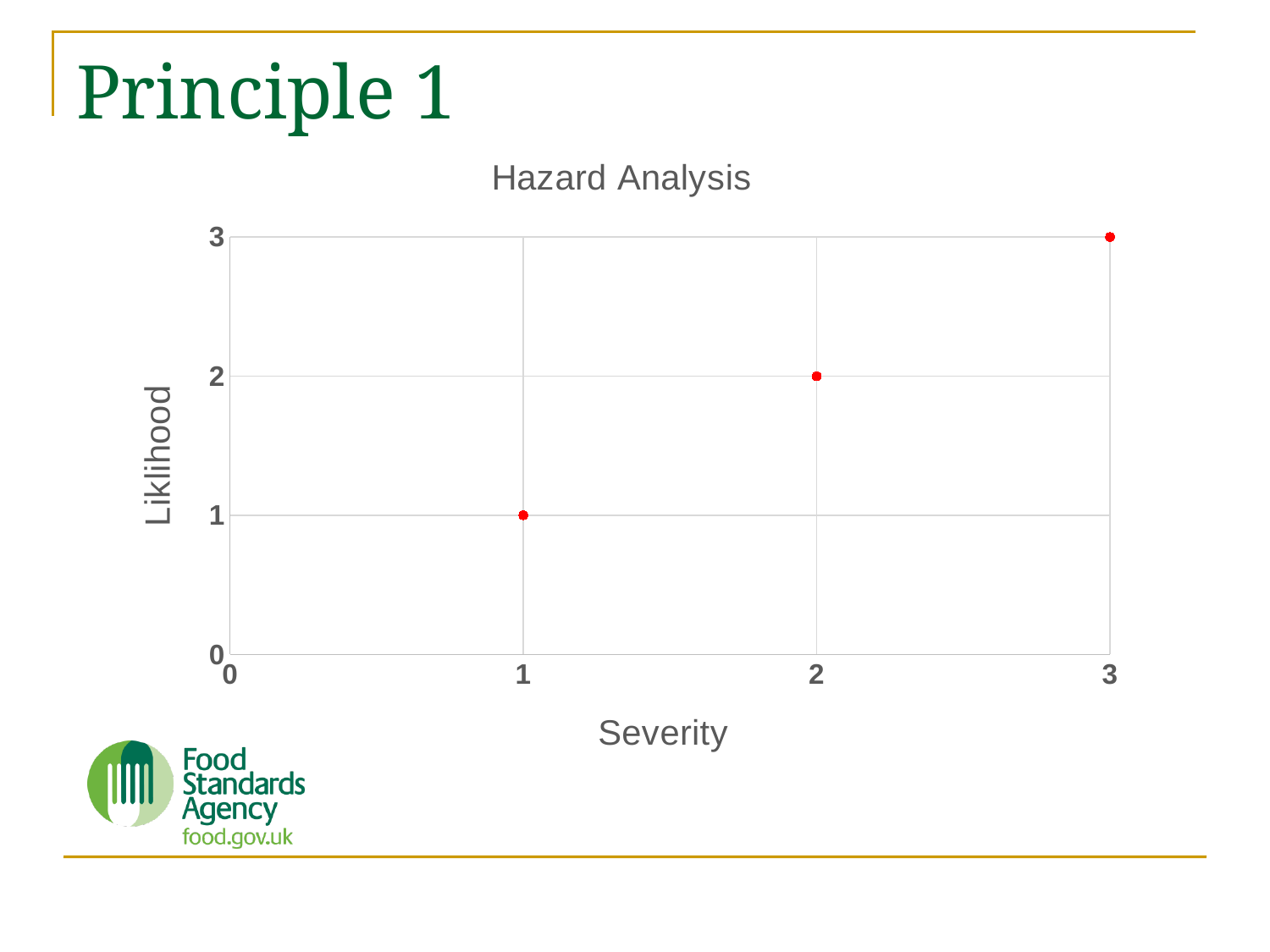
What is the difference in Liklihood between the points at Severity 3 and Severity 1? 2 What is the Liklihood value of the point at Severity 1? 1 How many data points are plotted on the chart? 3 Do the Liklihood values rise or fall as Severity increases along the x axis? rise What is the Liklihood value of the point at Severity 3? 3 At which Severity value does the point with the highest Liklihood appear? 3 At which Severity value does the point with the lowest Liklihood appear? 1 What is the Liklihood value of the point at Severity 2? 2 What kind of chart is shown on the slide? scatter chart What is the label of the x axis? Severity Which point has the larger Liklihood, the one at Severity 2 or the one at Severity 1? Severity 2 What is the title of the chart? Hazard Analysis